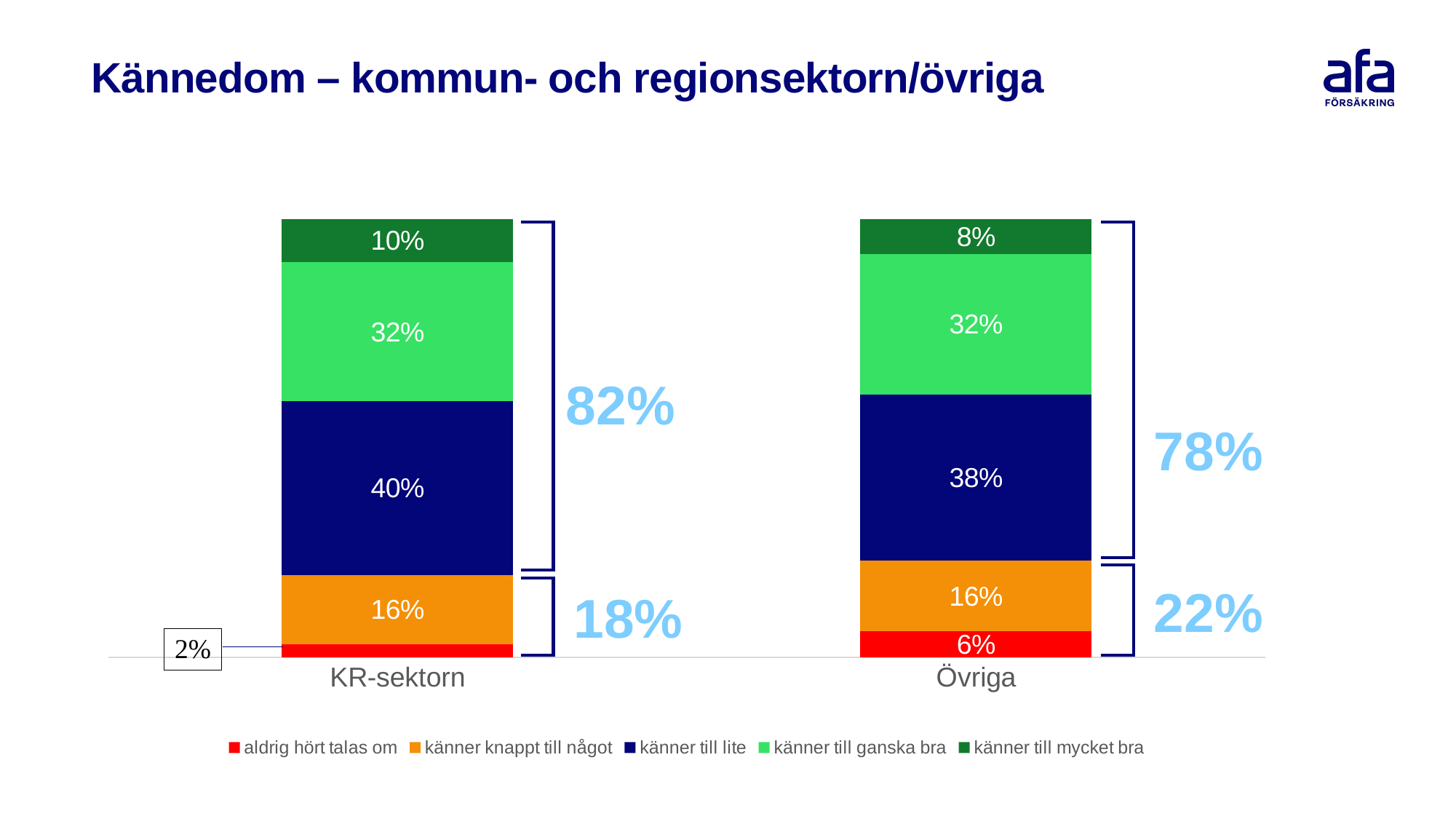
What is the value for "aldrig hört talas om" in the KR-sektorn bar? 2% Which segment is the largest in the Övriga bar? känner till lite What kind of chart is shown on the slide? Stacked bar chart What is the value for "känner till mycket bra" in the Övriga bar? 8% Which segment is the smallest in the KR-sektorn bar? aldrig hört talas om What is the value for "känner till lite" in the KR-sektorn bar? 40% What is the combined share of "känner till ganska bra" and "känner till mycket bra" for KR-sektorn? 42% How many categories are shown on the x axis? 2 What is the value for "känner knappt till något" in the Övriga bar? 16% Which category has the larger value for "aldrig hört talas om", KR-sektorn or Övriga? Övriga How many series does the legend list? 5 What is the difference between the "känner till lite" values for KR-sektorn and Övriga? 2%